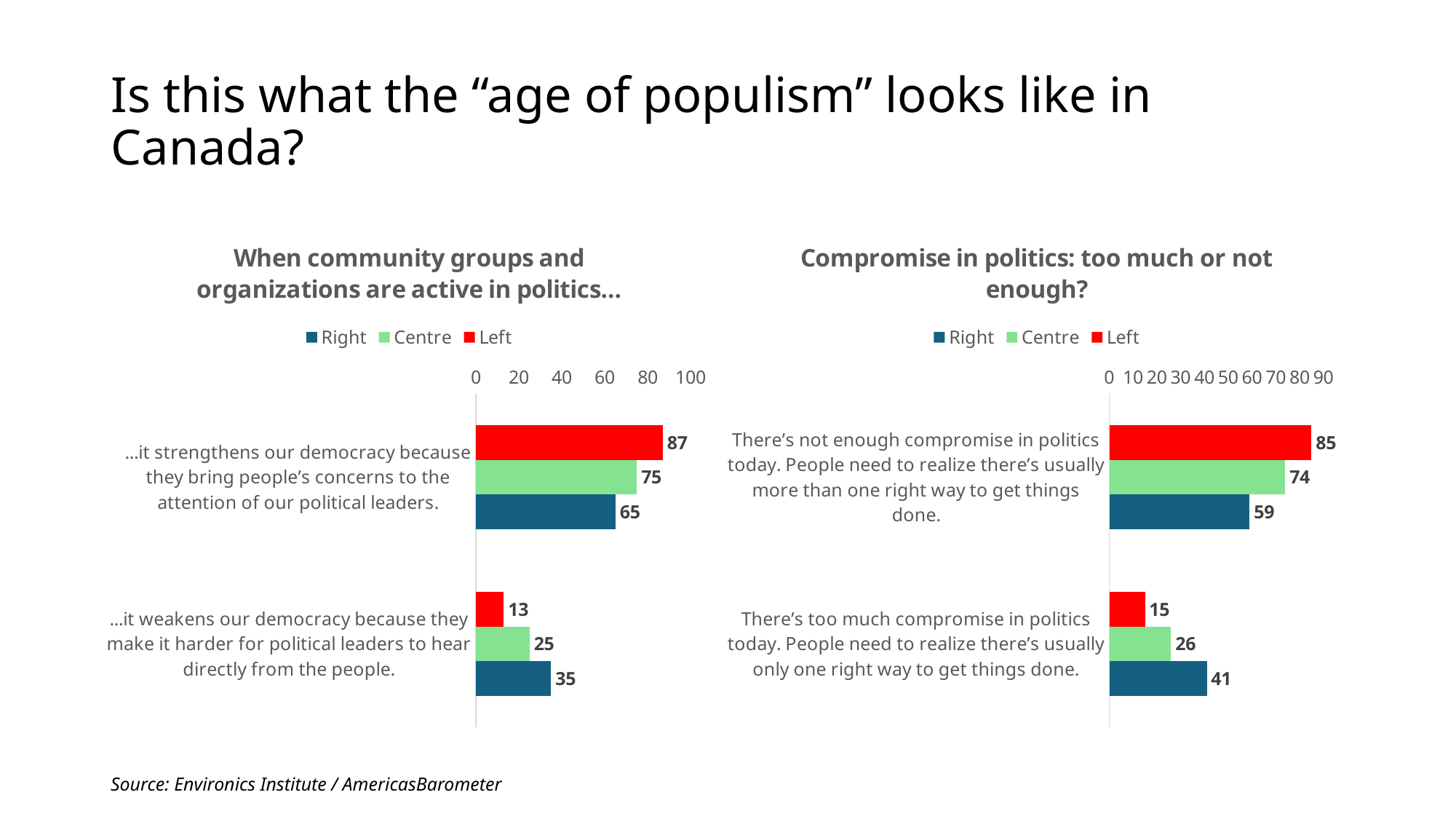
In the left chart, which series has the highest value for "...it strengthens our democracy..."? Left In the left chart ("When community groups and organizations are active in politics..."), what is the value for Left on "...it strengthens our democracy..."? 87 In the right chart ("Compromise in politics: too much or not enough?"), what is the value for Centre on "There's not enough compromise in politics today..."? 74 In the right chart, what is the difference between the Right and Centre values for "There's too much compromise in politics today..."? 15 In the right chart, which series has the lowest value for "There's too much compromise in politics today..."? Left What kind of chart is the right chart ("Compromise in politics: too much or not enough?")? Bar chart How many series does the legend of the left chart list? 3 In the left chart, what colour represents the Centre series? Green In the left chart, what is the difference between the Left and Right values for "...it strengthens our democracy..."? 22 In the right chart ("Compromise in politics: too much or not enough?"), what is the value for Left on "There's too much compromise in politics today..."? 15 In the right chart, which is larger for "There's not enough compromise in politics today...": the Left value or the Right value? Left In the left chart ("When community groups and organizations are active in politics..."), what is the value for Right on "...it weakens our democracy..."? 35